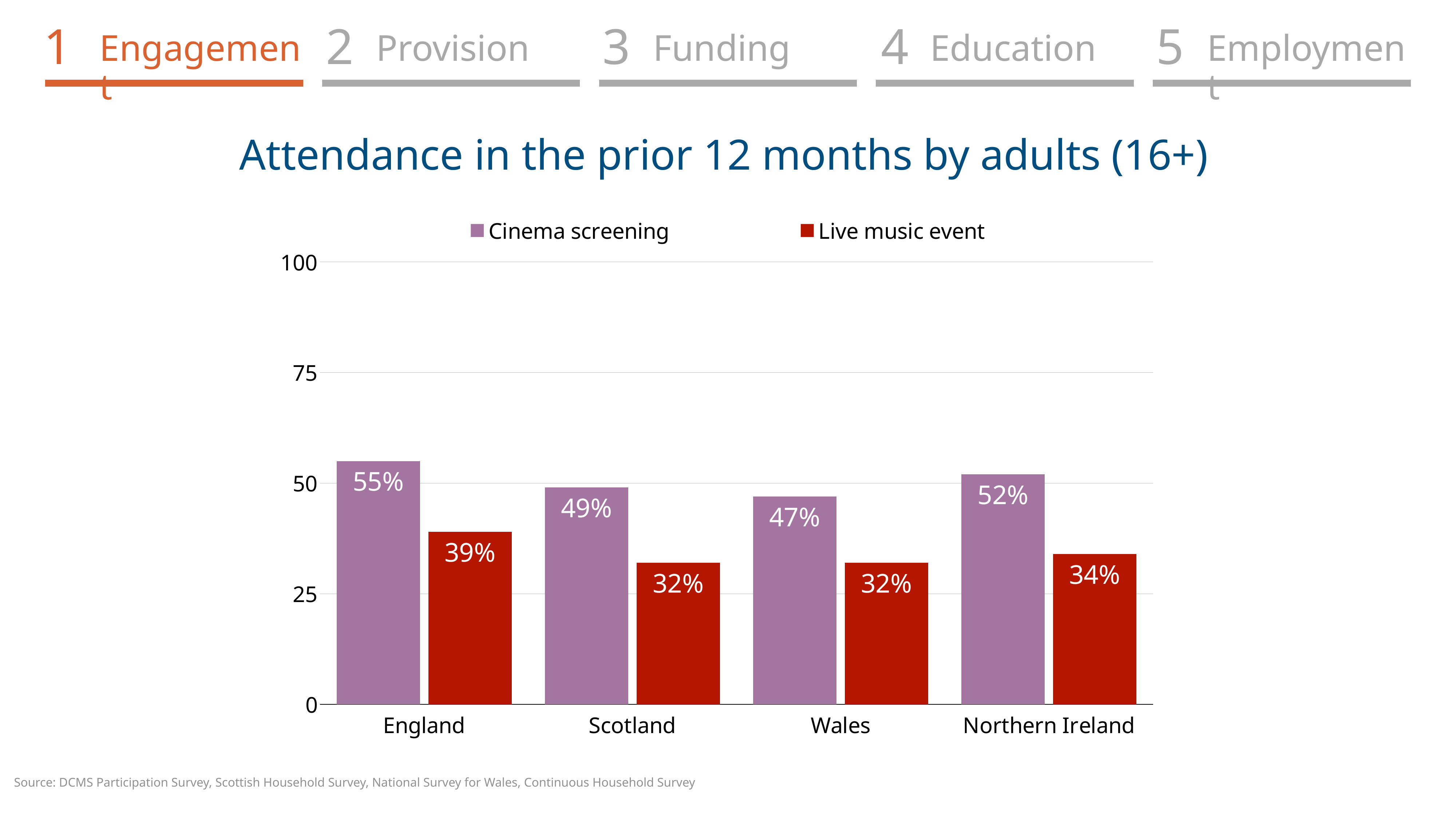
Which is larger: the Live music event value for Northern Ireland or for Scotland? Northern Ireland What is the difference between the Cinema screening and Live music event values for Wales? 15% How many countries are shown on the x axis? 4 Which country has the highest Live music event value? England What kind of chart is shown on the slide? Bar chart What is the title of the chart? Attendance in the prior 12 months by adults (16+) What is the Live music event value for Scotland? 32% What is the Cinema screening value for Northern Ireland? 52% What is the Cinema screening value for England? 55% How many series does the legend list? 2 Which country has the highest Cinema screening value? England Which country has the lowest Cinema screening value? Wales